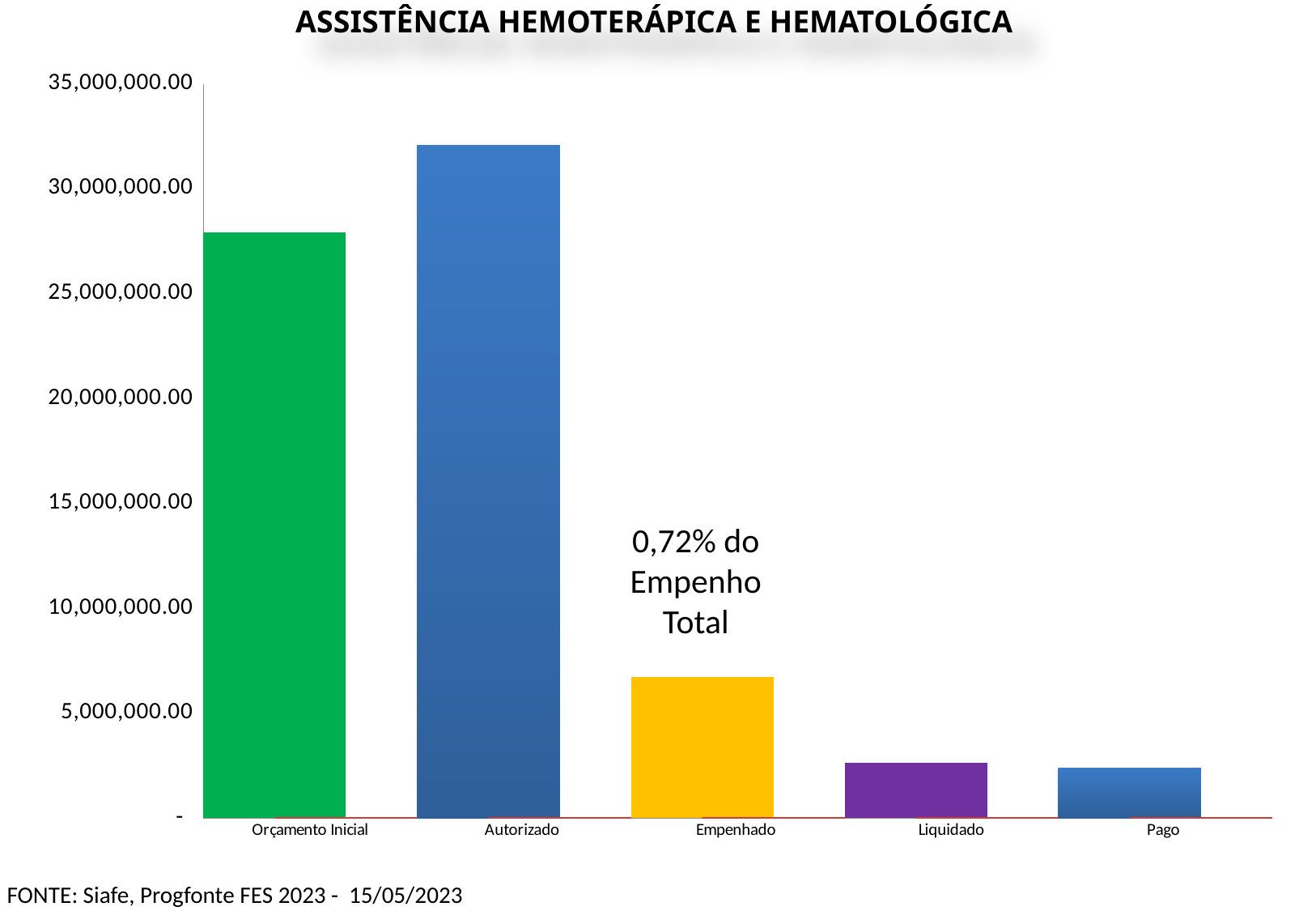
Is the value for Liquidado greater or less than 5,000,000.00? less What is the title of the chart? ASSISTÊNCIA HEMOTERÁPICA E HEMATOLÓGICA Is the value for Empenhado greater or less than 10,000,000.00? less From Autorizado to Pago, do the bar values rise or fall along the x axis? fall Is the value for Autorizado greater or less than 30,000,000.00? greater Which is larger, the value for Empenhado or the value for Orçamento Inicial? Orçamento Inicial Which category has the highest value in the chart? Autorizado What kind of chart is shown on the slide? bar chart Which is larger, the value for Orçamento Inicial or the value for Autorizado? Autorizado How many categories are shown on the x axis of the chart? 5